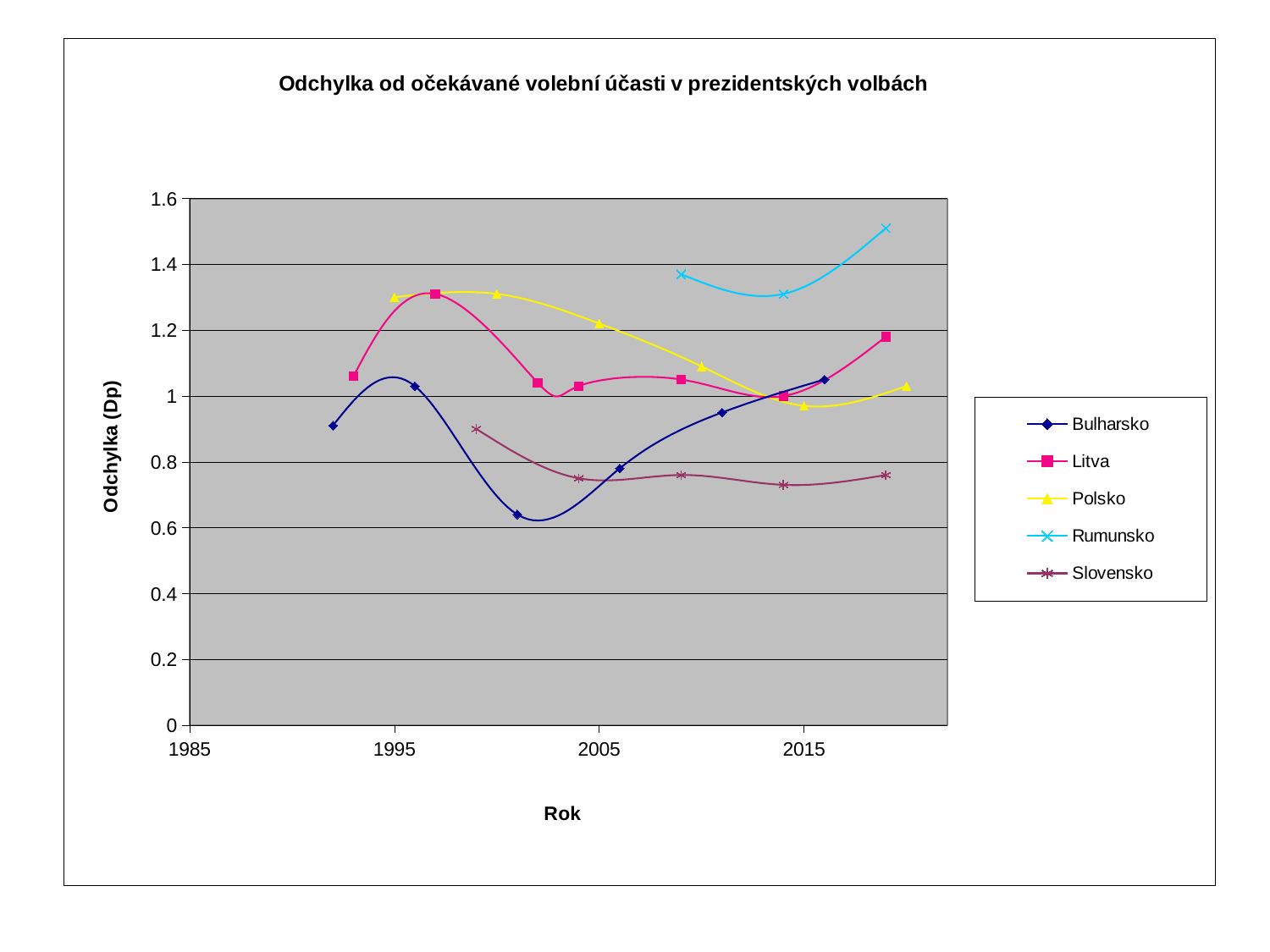
What is the label of the x axis? Rok How many series does the legend list? 5 Around 2014, which is larger: the value for Rumunsko or the value for Slovensko? Rumunsko What is the title of the chart? Odchylka od očekávané volební účasti v prezidentských volbách Is the lowest value for Bulharsko (around 2002) greater or less than 0.8? less How many data points are plotted for Rumunsko? 3 Do the values for Rumunsko rise or fall between its middle point (around 2014) and its last point (around 2019)? rise Is the last (rightmost) value for Rumunsko greater or less than 1.4? greater Which series reaches the highest value on the chart? Rumunsko Is the value for Polsko in 1995 greater or less than 1.2? greater Which series has the lowest point on the chart? Bulharsko What kind of chart is shown on the slide? Line chart